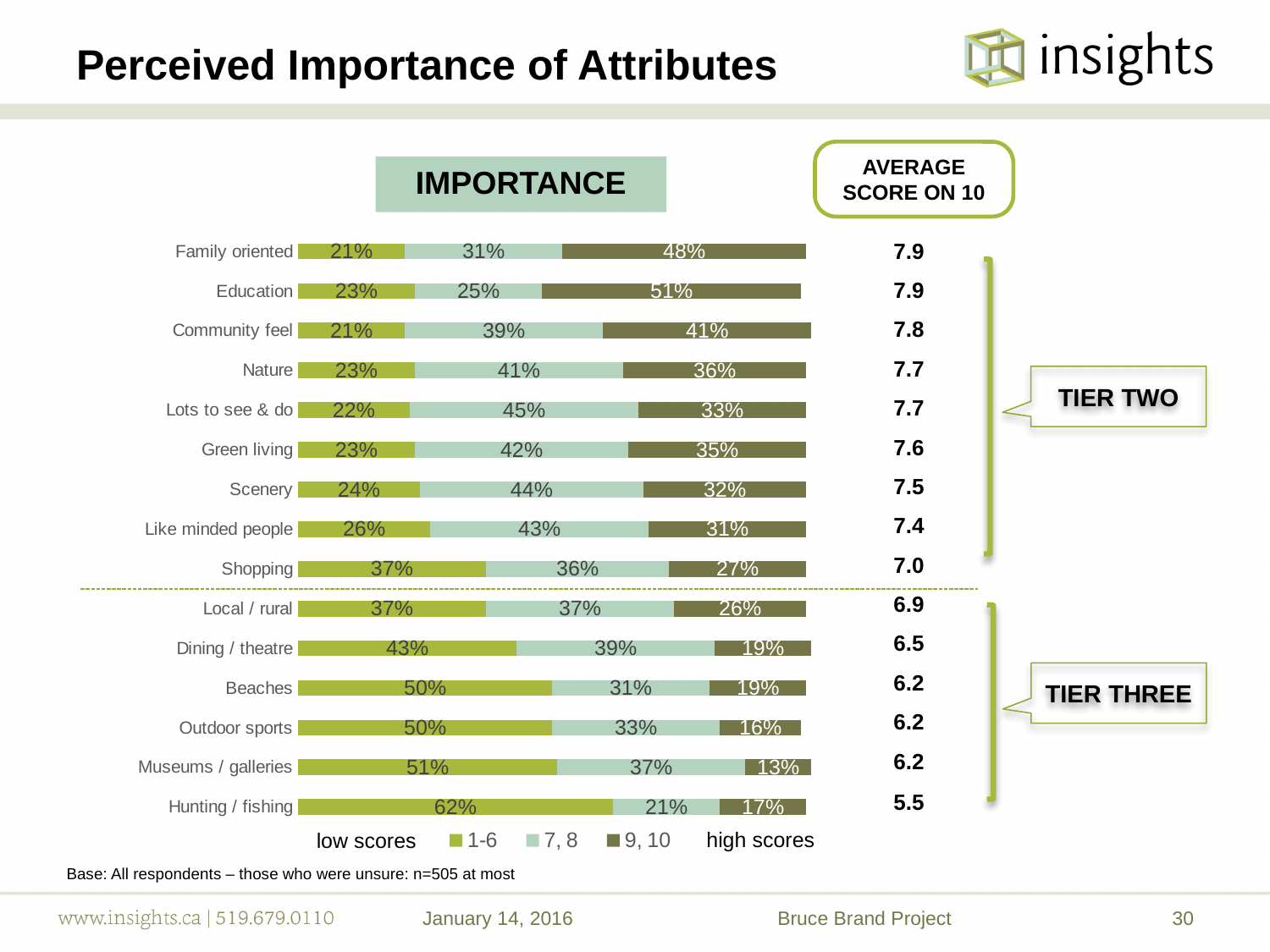
What percentage of respondents gave a score of 1-6 for Hunting / fishing? 62% How many attributes are shown in the chart? 15 Which has a larger share of 1-6 scores, Beaches or Dining / theatre? Beaches What are the three series listed in the legend? 1-6, 7, 8, and 9, 10 What is the difference between the 9, 10 share for Family oriented and the 9, 10 share for Shopping? 21% How many series does the legend list? 3 What percentage of respondents gave a score of 9 or 10 for Education? 51% Which attribute has the lowest share of 9, 10 scores? Museums / galleries What percentage of respondents gave a score of 7 or 8 for Lots to see & do? 45% Which attribute has the highest share of 1-6 scores? Hunting / fishing Which attribute has the highest share of 9, 10 scores? Education What kind of chart is shown on the slide? Stacked bar chart